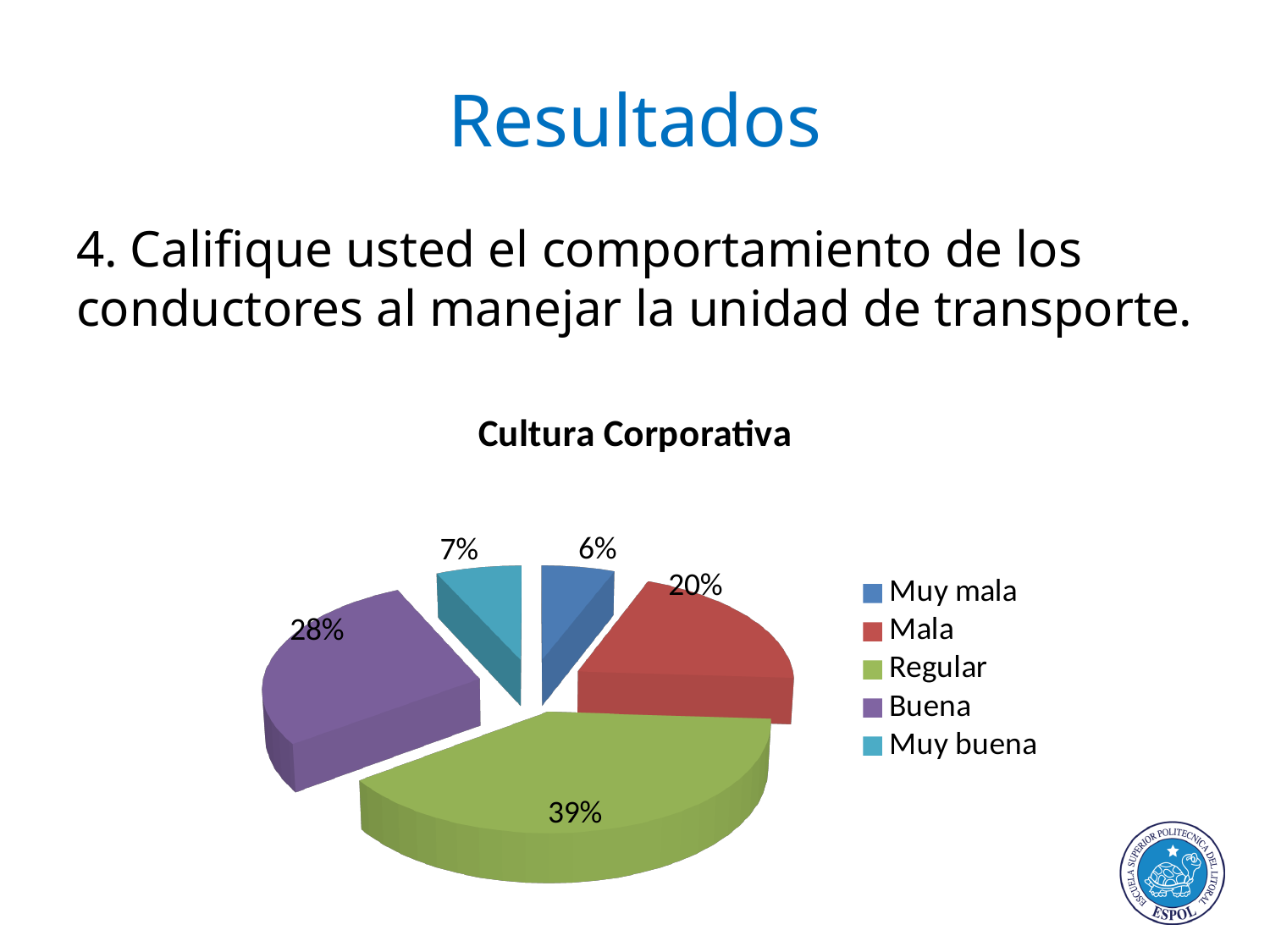
What is the difference in percentage points between Regular and Buena? 11 How many categories does the pie chart show? 5 Which category has the smallest share of the pie chart? Muy mala What percentage of the pie chart corresponds to Buena? 28% What is the title of the chart? Cultura Corporativa Which category has the largest share of the pie chart? Regular What type of chart is shown on the slide? Pie chart Which has a larger share, Mala or Buena? Buena What percentage of the pie chart corresponds to Regular? 39% What percentage of the pie chart corresponds to Muy buena? 7% What percentage of the pie chart corresponds to Mala? 20% What percentage of the pie chart corresponds to Muy mala? 6%